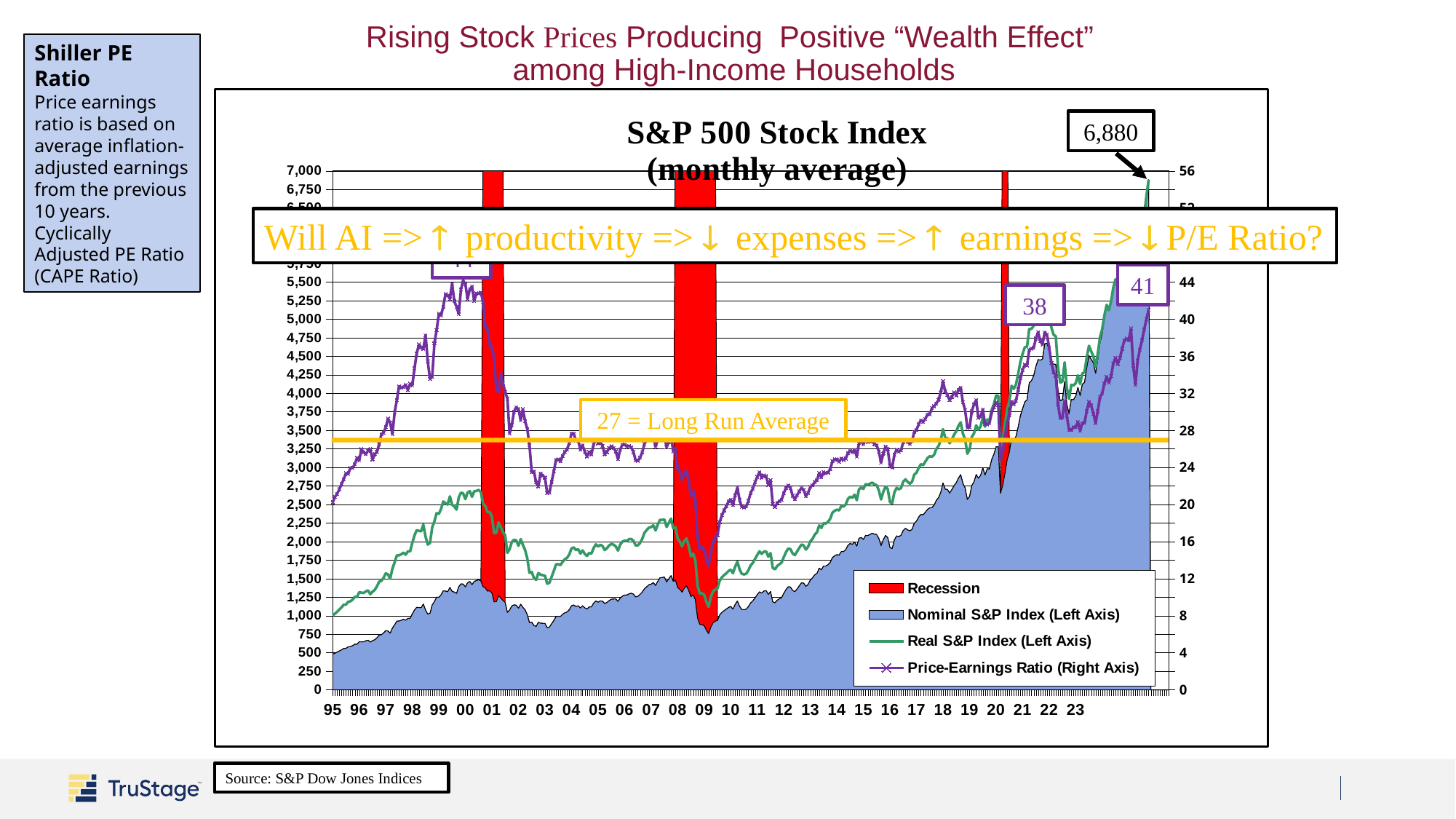
What is the most recent Price-Earnings Ratio value labeled on the chart? 41 Is the Nominal S&P Index value in 1995 greater or less than 1,000? less Which is larger, the Price-Earnings Ratio labeled 41 or the one labeled 38? 41 What value is given as the long run average of the Price-Earnings Ratio? 27 By how much does the latest labeled Price-Earnings Ratio of 41 exceed the long run average of 27? 14 What Price-Earnings Ratio value is labeled near 2021 on the chart? 38 Does the Nominal S&P Index generally rise or fall from 1995 to 2023? rise What is the title of the chart? S&P 500 Stock Index (monthly average) How many entries does the chart's legend list? 4 On which axis is the Price-Earnings Ratio plotted? Right axis What is the latest value of the S&P 500 index labeled on the chart? 6,880 How many recession periods are shaded on the chart? 3